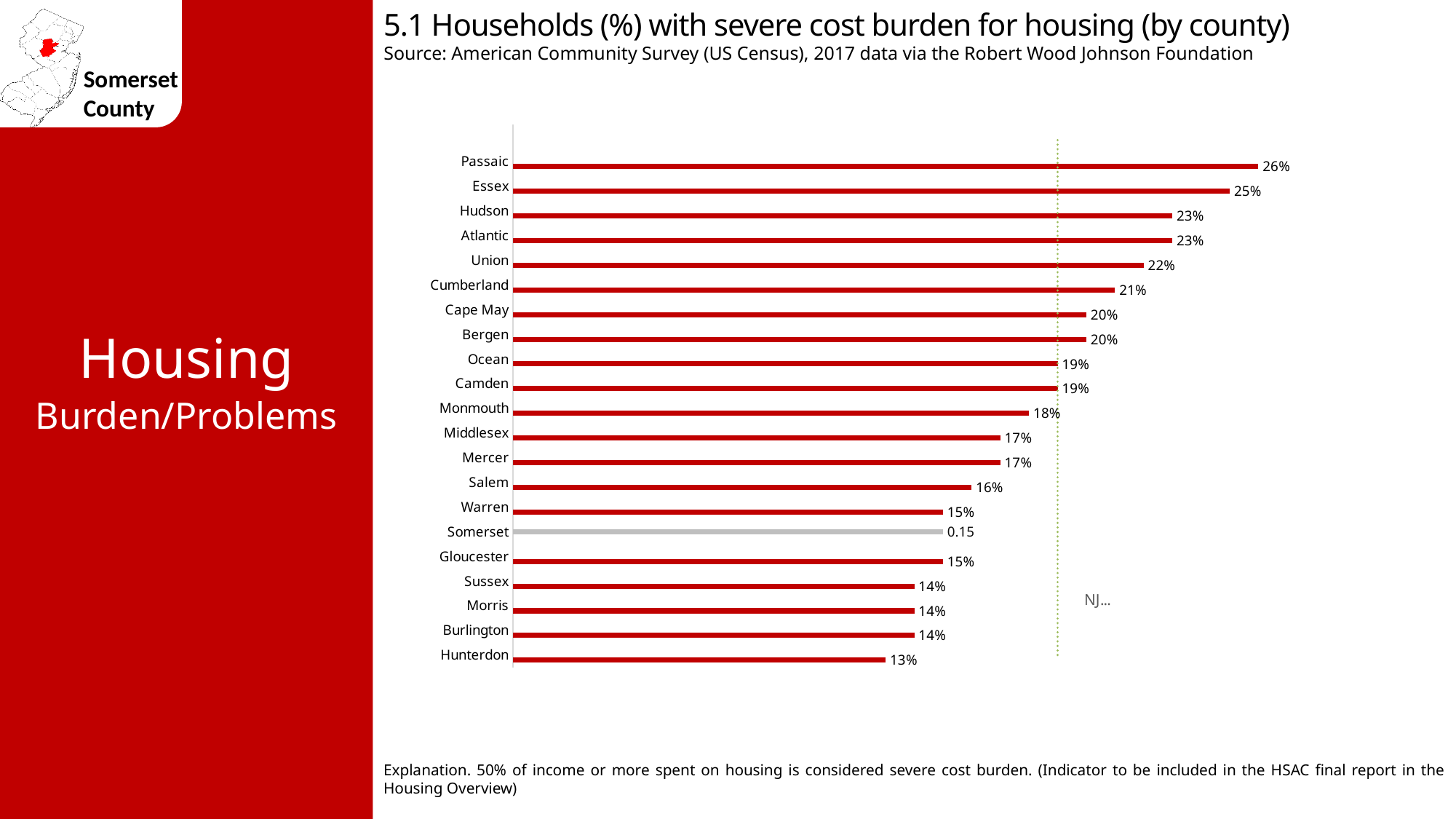
Which county has the highest value? Passaic Which county has the lowest value? Hunterdon What is the difference between the values for Passaic and Hunterdon? 13 percentage points Which county's bar is drawn in grey instead of red? Somerset What value is labelled on the Somerset bar? 0.15 What kind of chart is this? Bar chart Which is larger, the value for Union or the value for Cumberland? Union What is the value for Bergen? 20% What is the value for Monmouth? 18% What is the value for Passaic? 26% What is the difference between the values for Essex and Hudson? 2 percentage points How many counties are shown in the chart? 21